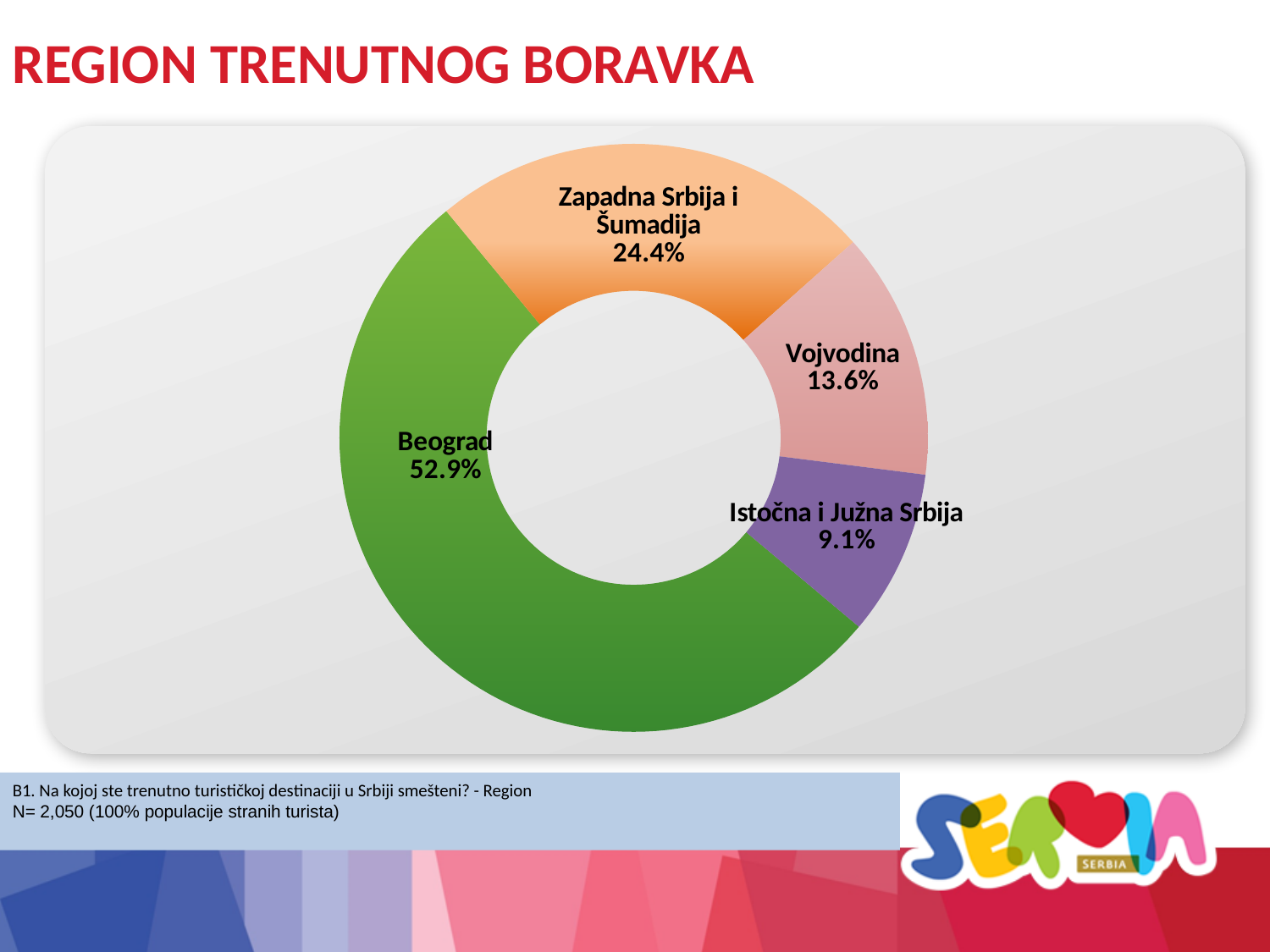
What is the title of the slide? REGION TRENUTNOG BORAVKA What kind of chart is shown on the slide? Doughnut (pie) chart What is the difference in percentage points between Vojvodina and Istočna i Južna Srbija? 4.5 What is the value shown for Vojvodina? 13.6% Which region has the smallest share? Istočna i Južna Srbija Which has a larger share, Vojvodina or Zapadna Srbija i Šumadija? Zapadna Srbija i Šumadija What is the value shown for Istočna i Južna Srbija? 9.1% Which region has the largest share? Beograd What is the value shown for Zapadna Srbija i Šumadija? 24.4% What is the difference in percentage points between Beograd and Zapadna Srbija i Šumadija? 28.5 How many regions are shown in the chart? 4 What share of the chart does Beograd account for? 52.9%